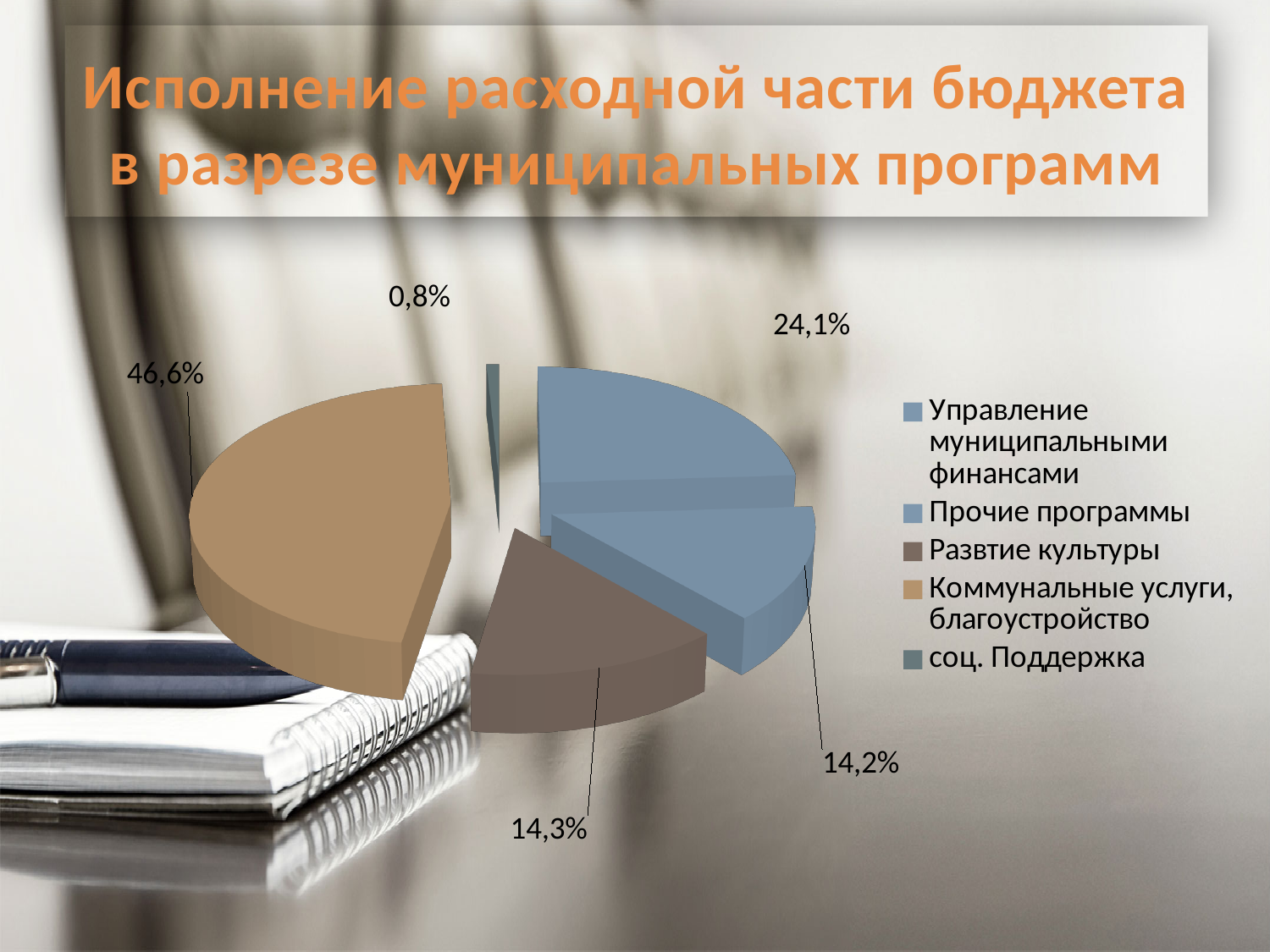
What share of the pie is labelled for Коммунальные услуги, благоустройство? 46,6% Which category has the largest slice of the pie? Коммунальные услуги, благоустройство How many entries does the legend list? 5 Which is larger: the slice for Коммунальные услуги, благоустройство or the slice for Развтие культуры? Коммунальные услуги, благоустройство What is the title of the slide? Исполнение расходной части бюджета в разрезе муниципальных программ How many slices does the pie chart have? 5 What is the combined share of the two slices labelled 14,3% and 14,2%? 28,5% Which category has the smallest slice of the pie? соц. Поддержка What share of the pie is labelled for соц. Поддержка? 0,8% What kind of chart is shown on the slide? pie chart By how many percentage points does the share for Коммунальные услуги, благоустройство exceed the share for Развтие культуры? 32,3 What share of the pie is labelled for Развтие культуры? 14,3%